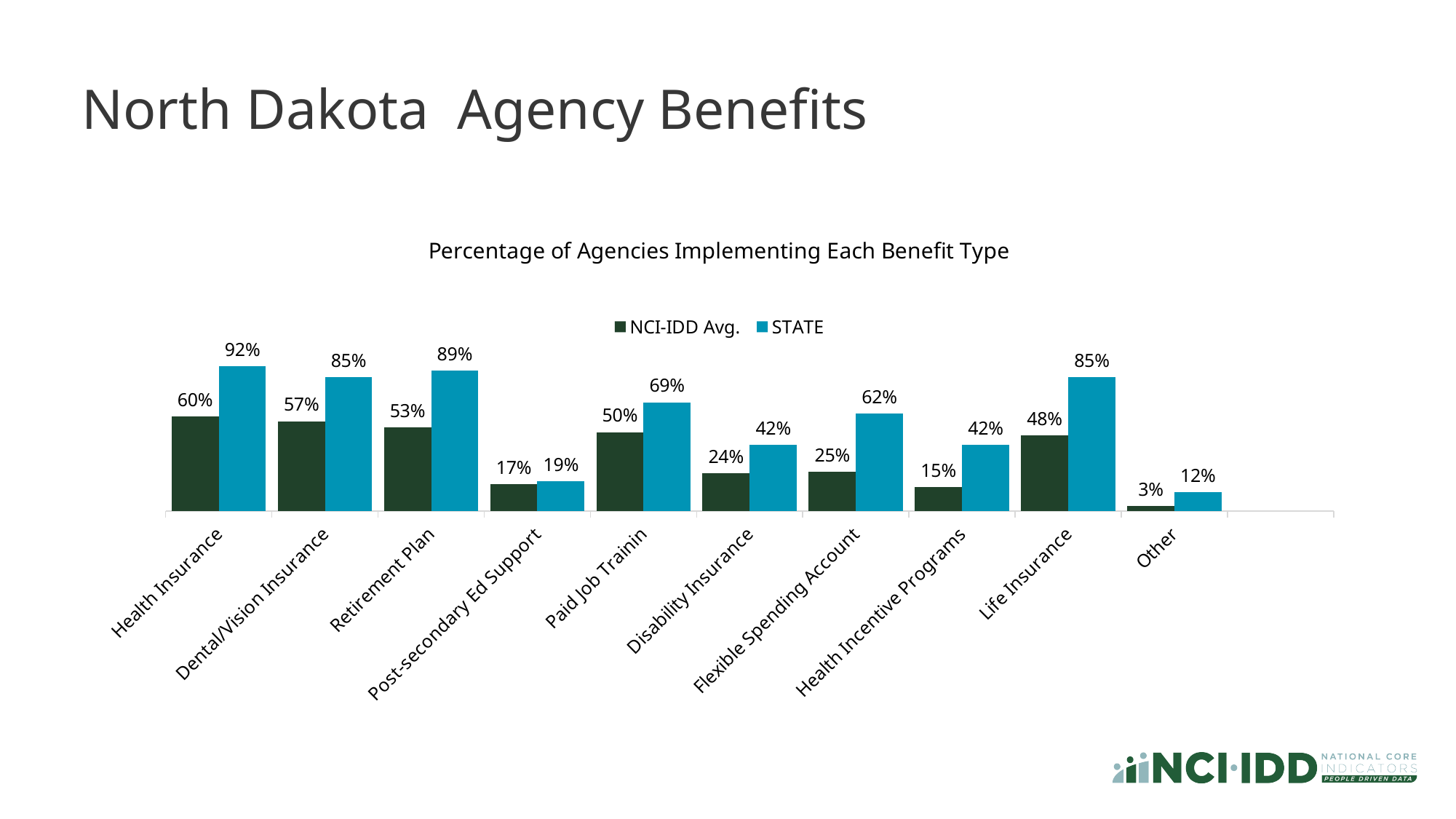
What is the STATE value for Health Insurance? 92% What is the NCI-IDD Avg. value for Flexible Spending Account? 25% What is the difference between the STATE and NCI-IDD Avg. values for Post-secondary Ed Support? 2% Which category has the highest STATE value? Health Insurance How many benefit categories are shown on the x axis? 10 Which category has the lowest NCI-IDD Avg. value? Other What is the difference between the STATE and NCI-IDD Avg. values for Retirement Plan? 36% What kind of chart is shown on the slide? Bar chart What is the STATE value for Other? 12% Which is larger for Paid Job Trainin, the NCI-IDD Avg. value or the STATE value? STATE How many series does the legend list? 2 What is the title of the chart? Percentage of Agencies Implementing Each Benefit Type